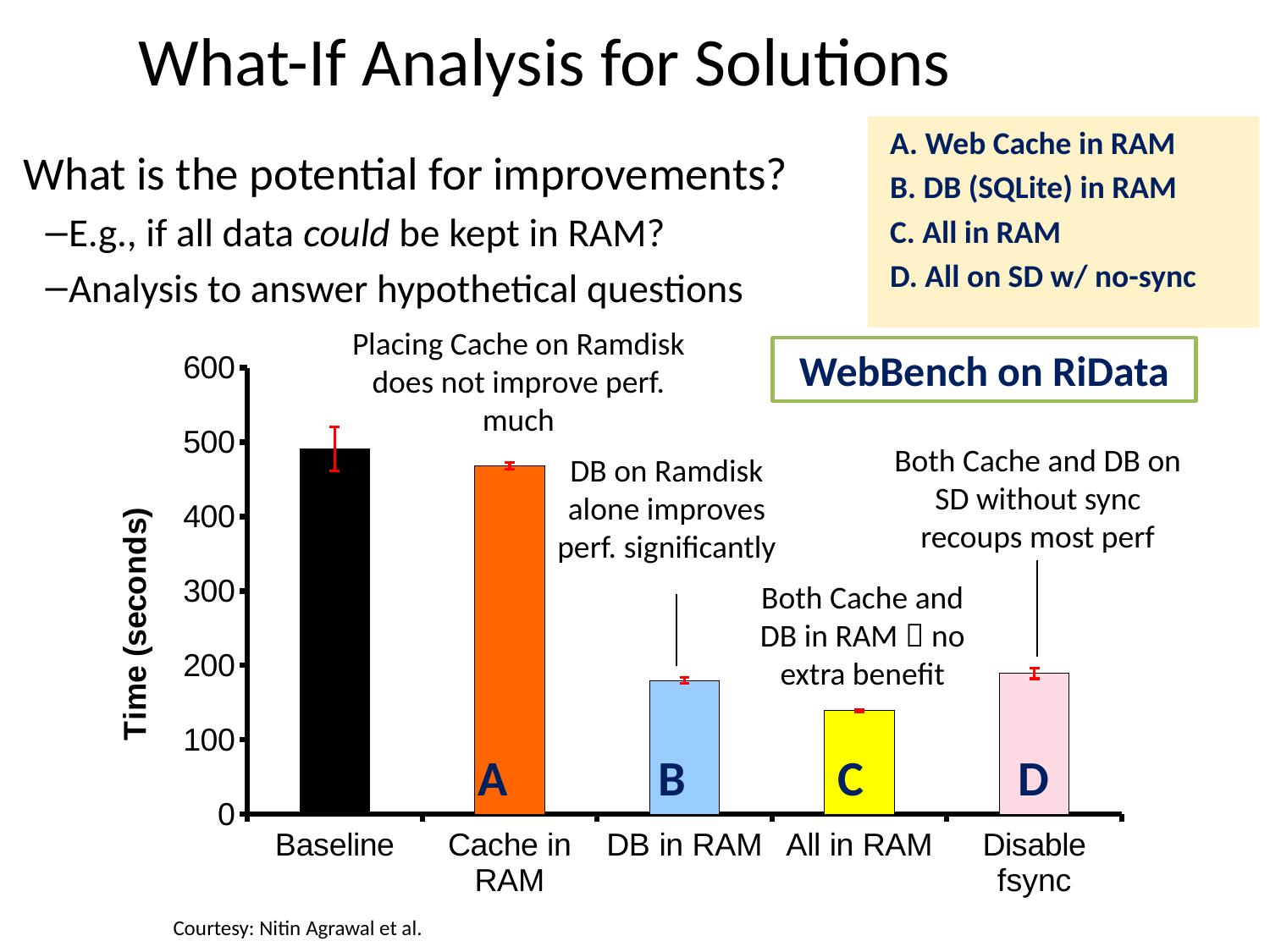
Which has a larger value, Baseline or DB in RAM? Baseline Which category has the highest time in the chart? Baseline Is the value for DB in RAM greater or less than 200? less How many categories are plotted on the x axis of the chart? 5 What kind of chart is shown on the slide? bar chart Is the value for Disable fsync greater or less than 300? less Is the value for Baseline greater or less than 400? greater Which has a larger value, DB in RAM or All in RAM? DB in RAM What is the label of the y axis of the chart? Time (seconds) Which category has the lowest time in the chart? All in RAM What benchmark and device does the boxed label above the chart name? WebBench on RiData